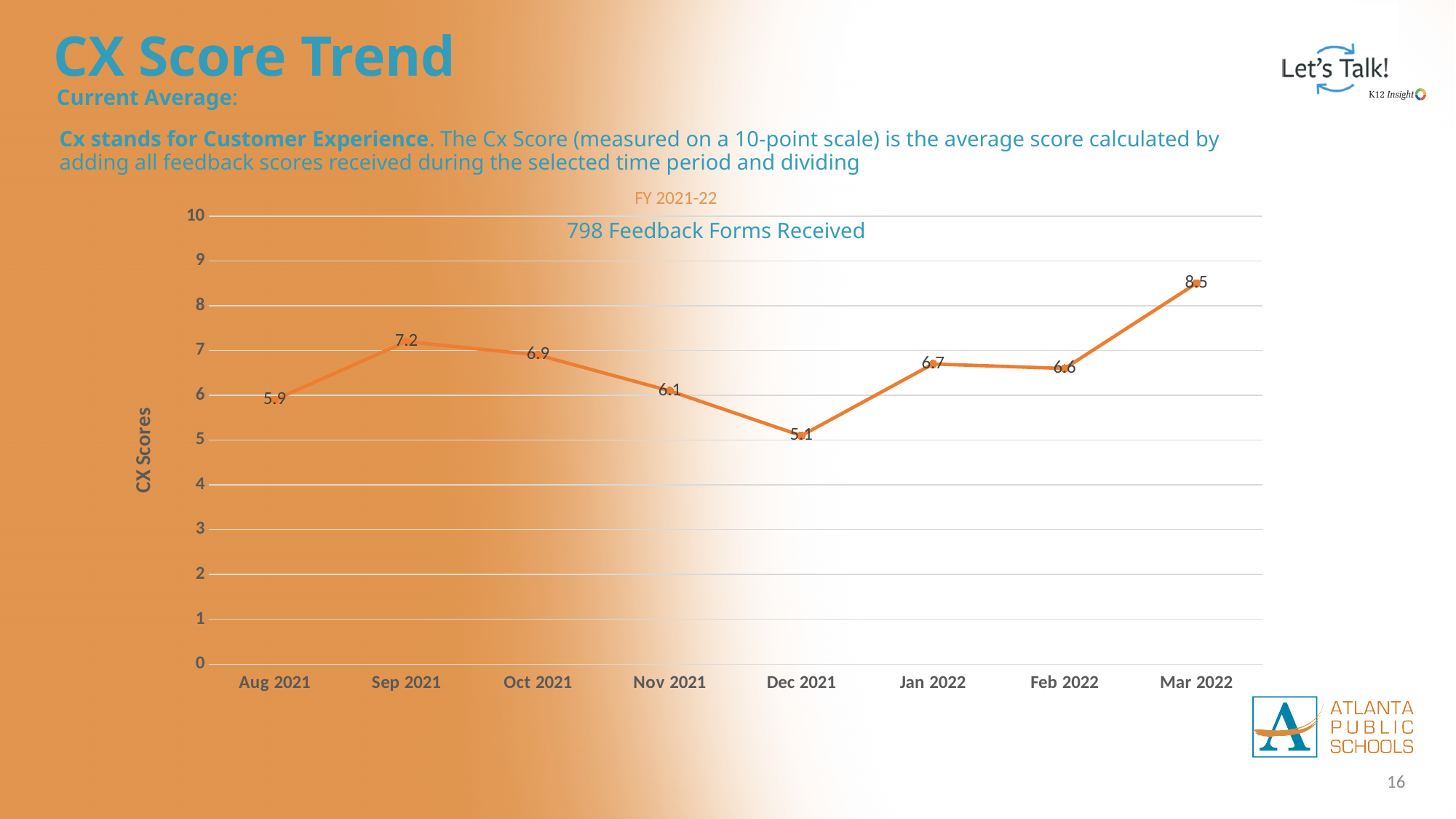
What is the CX score for Aug 2021? 5.9 Which month has the highest CX score? Mar 2022 What is the CX score for Dec 2021? 5.1 What is the difference between the CX scores for Mar 2022 and Dec 2021? 3.4 What kind of chart is shown on the slide? line chart Which month has the lowest CX score? Dec 2021 Is the CX score for Nov 2021 greater or less than 7? less Does the CX score rise or fall from Sep 2021 to Dec 2021? fall How many months are plotted on the chart? 8 What is the CX score for Mar 2022? 8.5 Which has a higher CX score, Sep 2021 or Oct 2021? Sep 2021 What is the label on the vertical axis of the chart? CX Scores